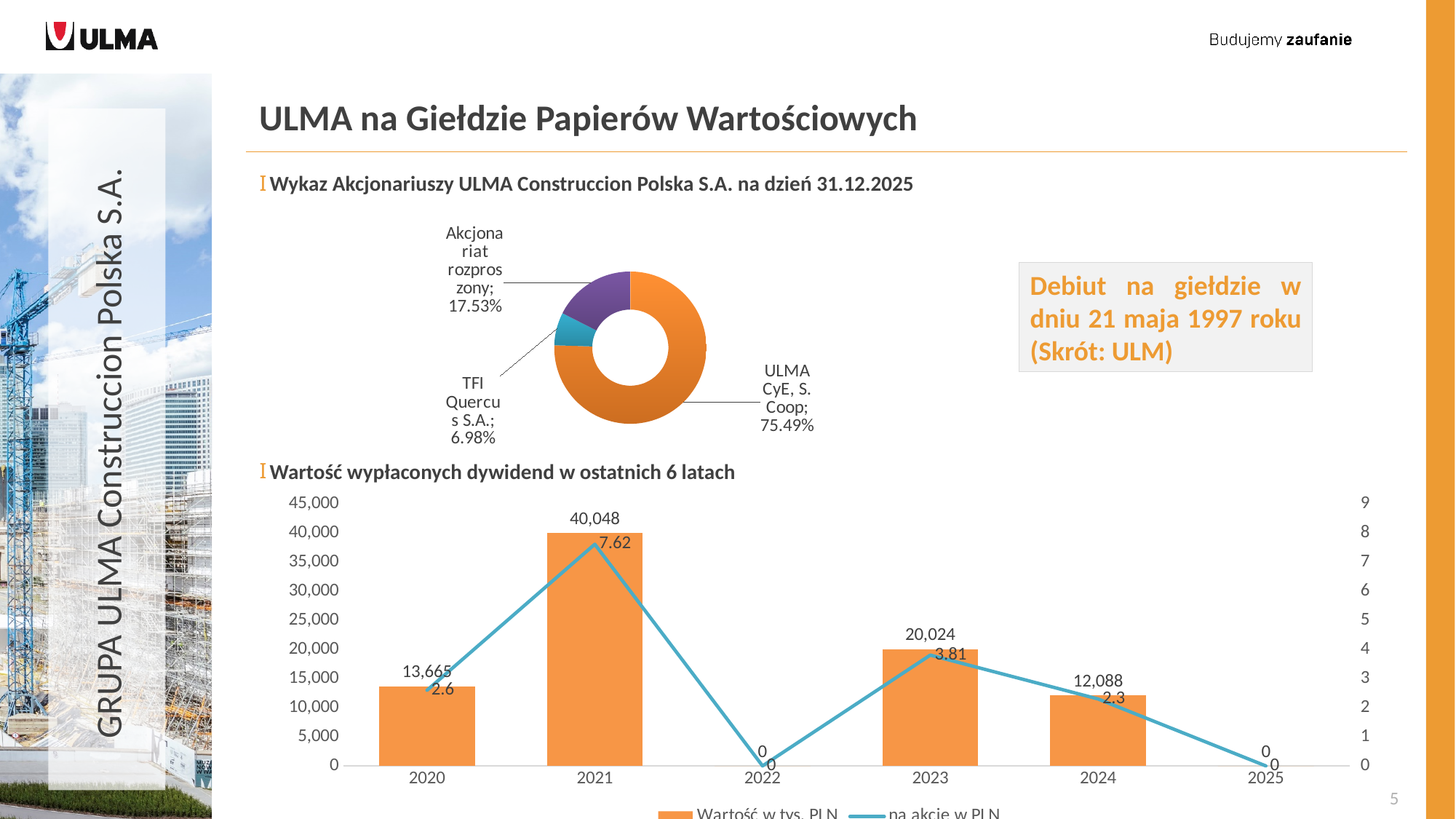
In the dividends chart, what is the per-share value (na akcję w PLN) for 2023? 3.81 How many years are shown on the x axis of the dividends chart? 6 In the dividends chart, what is the difference between the bar values for 2023 and 2024? 7,936 In the shareholder pie chart, what share does TFI Quercus S.A. hold? 6.98% In the dividends chart, is the bar value for 2020 larger than the bar value for 2024? Yes, 2020 In the dividends chart, what is the per-share value for 2021? 7.62 How many slices does the shareholder pie chart have? 3 How many series does the legend of the dividends chart list? 2 In the shareholder pie chart (Wykaz Akcjonariuszy), what share does ULMA CyE, S. Coop hold? 75.49% In the dividends chart (Wartość wypłaconych dywidend), what is the value of the bar for 2021? 40,048 In the dividends chart, which year has the highest bar value? 2021 In the shareholder pie chart, which shareholder has the smallest share? TFI Quercus S.A.